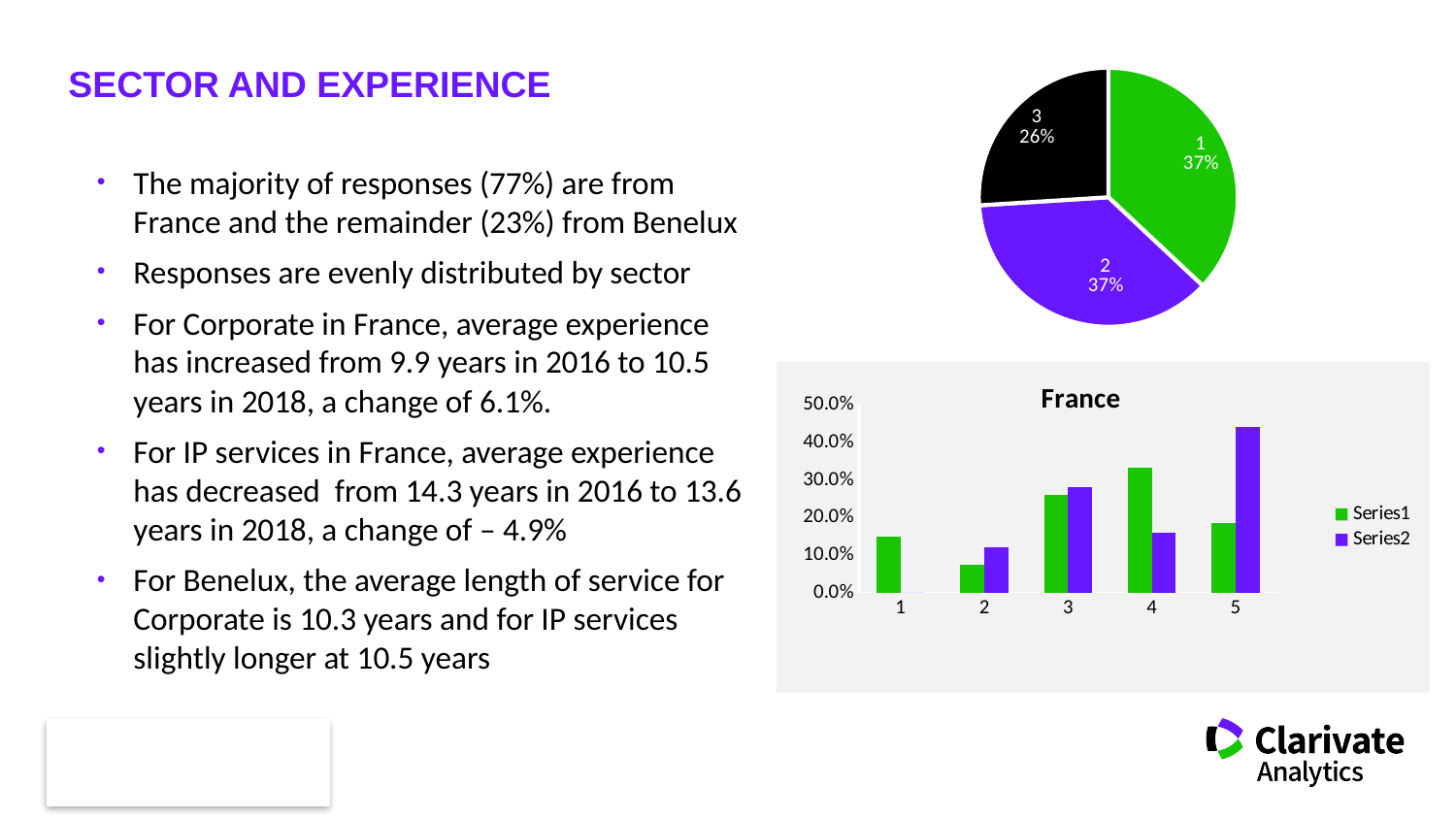
How many series does the legend of the 'France' chart list? 2 How many categories are shown on the x axis of the 'France' chart? 5 In the 'France' chart, which category has the lowest value for Series1? 2 In the pie chart at the top right, which slice has the smallest share? 3 In the pie chart at the top right, what percentage is shown for slice 3? 26% What type of chart is the chart titled 'France'? bar chart In the pie chart at the top right, what is the difference in percentage points between slice 1 and slice 3? 11 In the 'France' chart, which category has the highest value for Series2? 5 In the pie chart at the top right, what percentage is shown for slice 1? 37% In the 'France' chart, is the Series2 value for category 5 greater or less than 40.0%? greater How many slices does the pie chart at the top right have? 3 In the 'France' chart, for category 4, which series has the larger value, Series1 or Series2? Series1